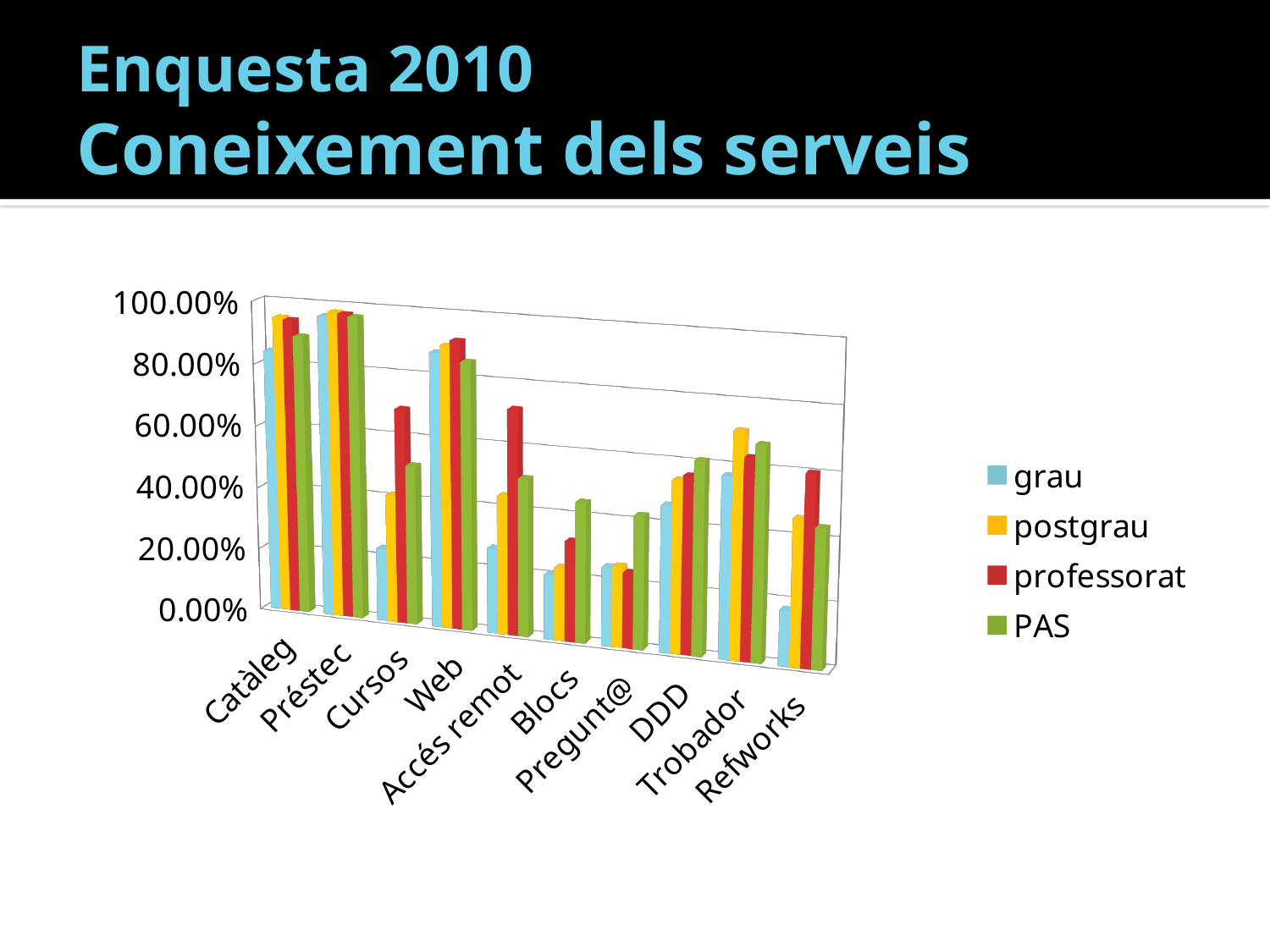
Which category has the lowest value for grau? Refworks Which is larger for Cursos, the value for grau or the value for professorat? professorat How many series does the chart's legend list? 4 Is the value for grau in Refworks greater or less than 20.00%? less What kind of chart is shown on the slide? bar chart Is the value for grau in Cursos greater or less than 40.00%? less Which is larger for Refworks, the value for grau or the value for professorat? professorat Is the value for grau in Préstec greater or less than 80.00%? greater Which category has the lowest value for professorat? Pregunt@ How many categories are shown along the x axis of the chart? 10 Which series are listed in the chart's legend? grau, postgrau, professorat, PAS